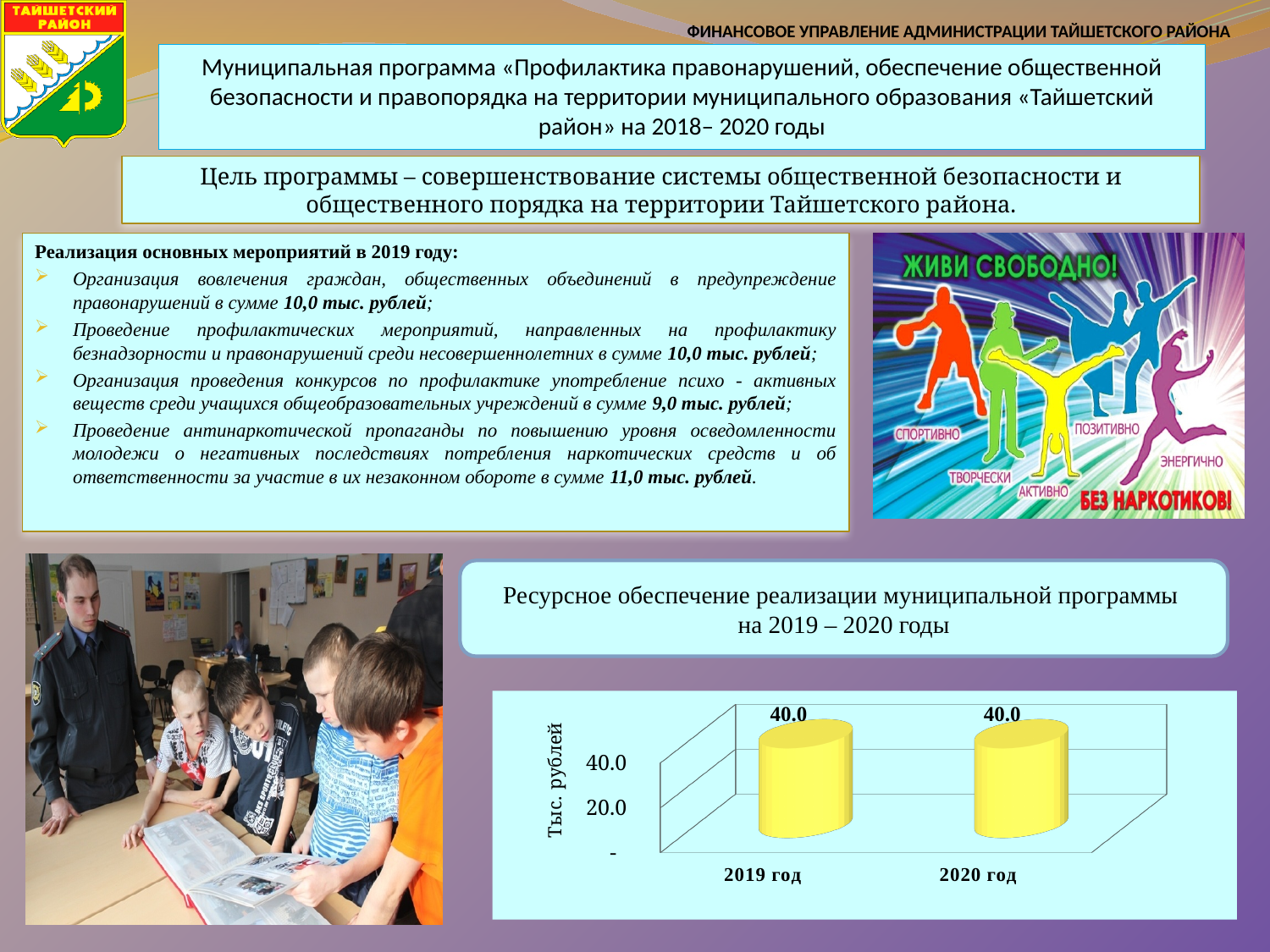
How many categories are shown on the x axis of the chart? 2 What kind of chart is shown on the slide? bar chart What is the value for 2019 год in the chart? 40.0 What colour are the bars in the chart? yellow What is the total of the values for 2019 год and 2020 год? 80.0 What is the difference between the values for 2019 год and 2020 год? 0.0 What is the value for 2020 год in the chart? 40.0 Do the values rise, fall or stay the same from 2019 год to 2020 год? stay the same What is the label on the vertical axis of the chart? Тыс. рублей Is the value for 2019 год greater or less than 20.0? greater Is the value for 2020 год greater or less than 20.0? greater